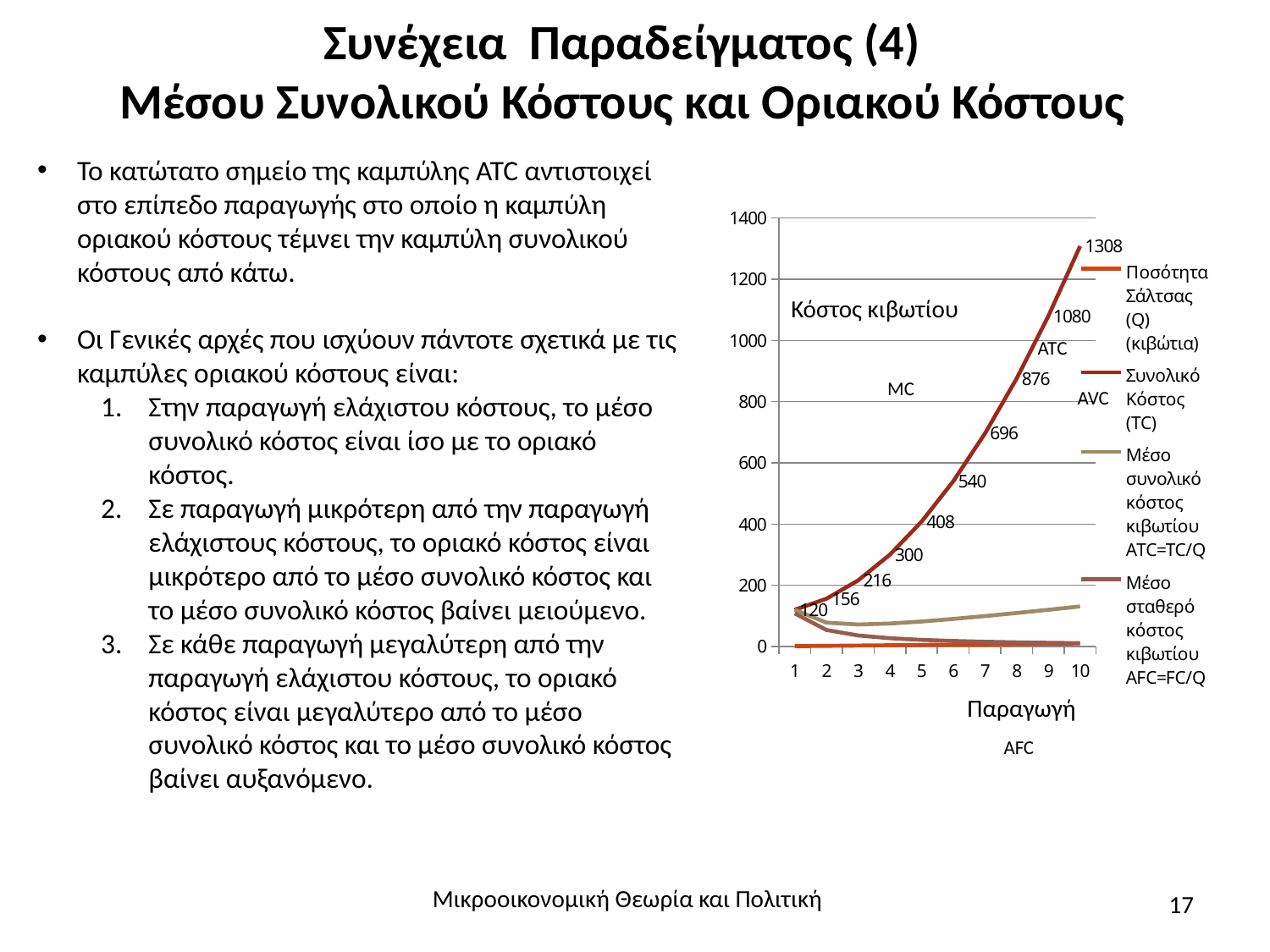
How many production levels are shown on the x axis? 10 How many series does the legend list? 4 At which production level is Συνολικό Κόστος (TC) lowest? 1 Does Συνολικό Κόστος (TC) rise or fall as production increases from 1 to 10? rise What is the value of Συνολικό Κόστος (TC) at production level 8? 876 What is the value of Συνολικό Κόστος (TC) at production level 10? 1308 What is the value of Συνολικό Κόστος (TC) at production level 1? 120 What is the value of Συνολικό Κόστος (TC) at production level 5? 408 What kind of chart is shown on the slide? line chart What is the difference between Συνολικό Κόστος (TC) at production level 10 and at production level 9? 228 Which is larger: Συνολικό Κόστος (TC) at production level 6 or at production level 4? production level 6 At which production level is Συνολικό Κόστος (TC) highest? 10